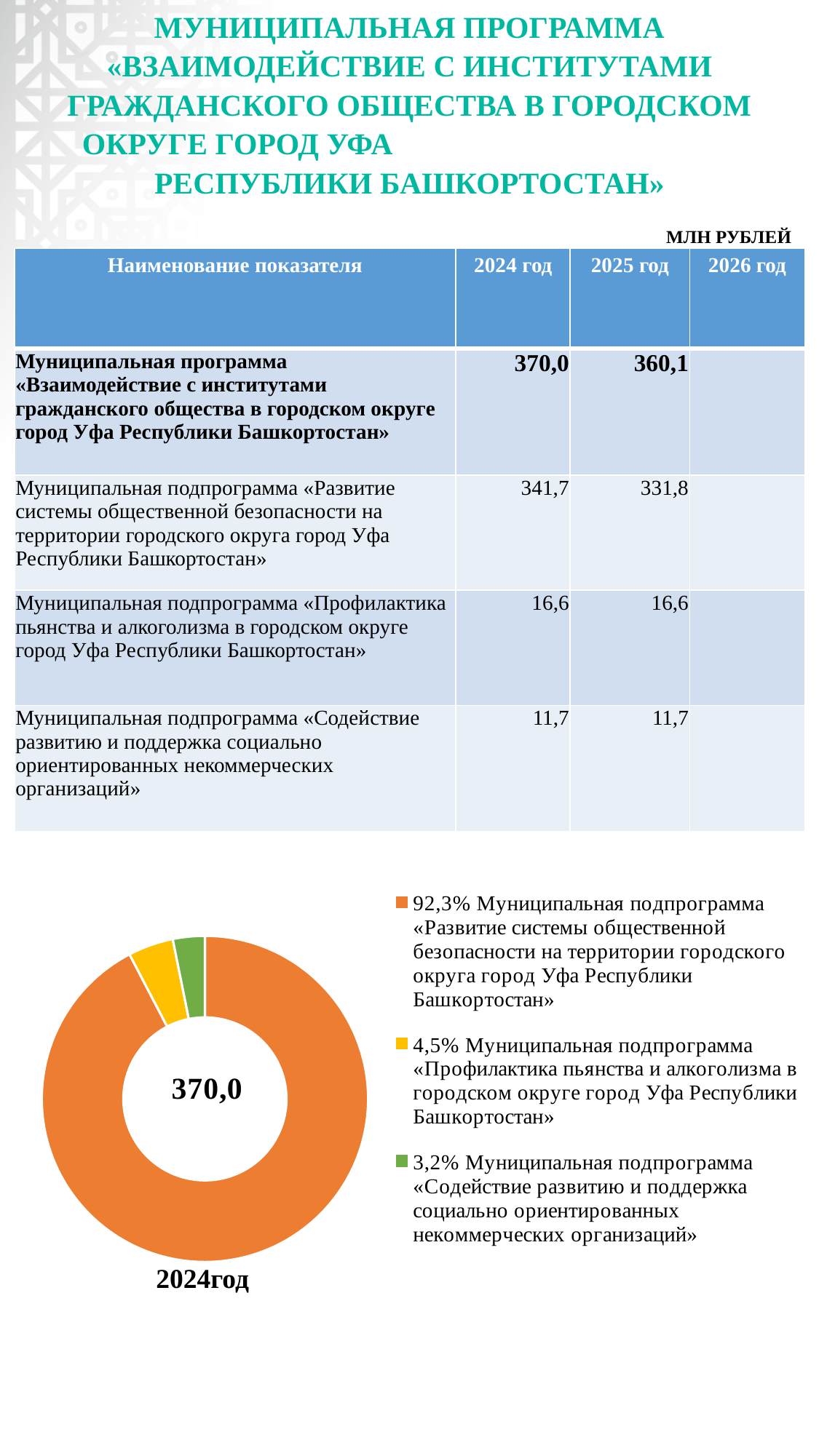
What kind of chart is shown at the bottom of the slide? Pie chart (doughnut) Which subprogram has the smallest slice in the pie chart? Муниципальная подпрограмма «Содействие развитию и поддержка социально ориентированных некоммерческих организаций» What share of the pie chart does the subprogram «Развитие системы общественной безопасности на территории городского округа город Уфа Республики Башкортостан» take? 92,3% How many slices does the pie chart have? 3 How many entries does the legend of the pie chart list? 3 What value is printed in the centre of the doughnut chart? 370,0 What is the difference in percentage points between the largest slice (92,3%) and the yellow slice (4,5%) in the pie chart? 87,8 What share of the pie chart does the subprogram «Профилактика пьянства и алкоголизма в городском округе город Уфа Республики Башкортостан» take? 4,5% What share of the pie chart does the subprogram «Содействие развитию и поддержка социально ориентированных некоммерческих организаций» take? 3,2% Which subprogram has the largest slice in the pie chart? Муниципальная подпрограмма «Развитие системы общественной безопасности на территории городского округа город Уфа Республики Башкортостан» In the pie chart, which is larger: the share of the subprogram «Профилактика пьянства и алкоголизма...» or the share of the subprogram «Содействие развитию и поддержка социально ориентированных некоммерческих организаций»? «Профилактика пьянства и алкоголизма...» (4,5%) Which year does the pie chart refer to, according to the label below it? 2024год